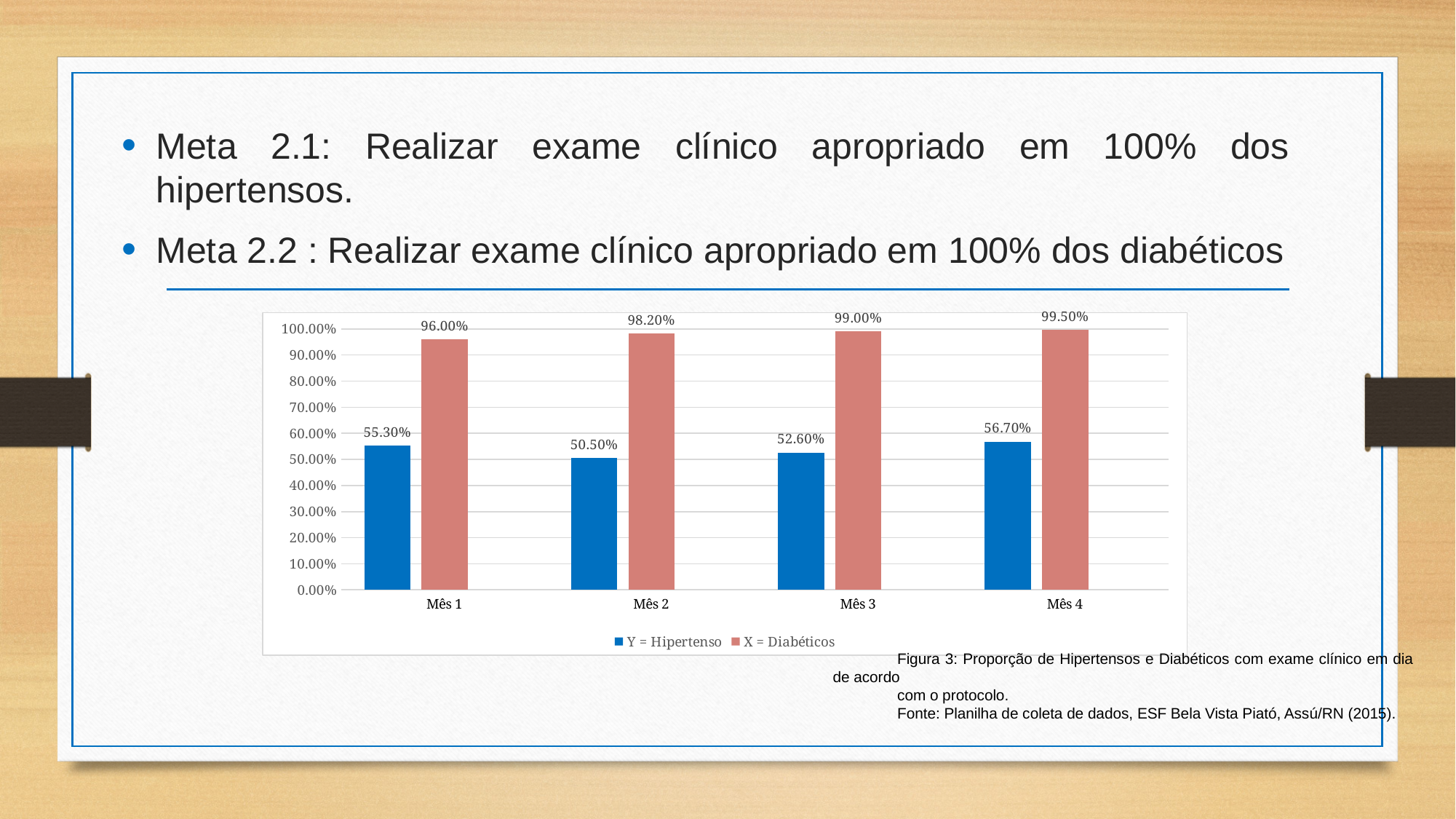
What is the value for Y = Hipertenso in Mês 1? 55.30% Which is larger in Mês 3: the Y = Hipertenso value or the X = Diabéticos value? X = Diabéticos What kind of chart is shown on the slide? Bar chart Is the value for Y = Hipertenso in Mês 2 greater or less than 60.00%? less How many series does the legend list? 2 What is the difference between the X = Diabéticos and Y = Hipertenso values in Mês 2? 47.70% In which month is the Y = Hipertenso value lowest? Mês 2 What is the value for X = Diabéticos in Mês 3? 99.00% Does the X = Diabéticos value rise or fall from Mês 1 to Mês 4? Rise In which month is the X = Diabéticos value highest? Mês 4 What is the value for Y = Hipertenso in Mês 4? 56.70% How many months are shown on the x axis? 4